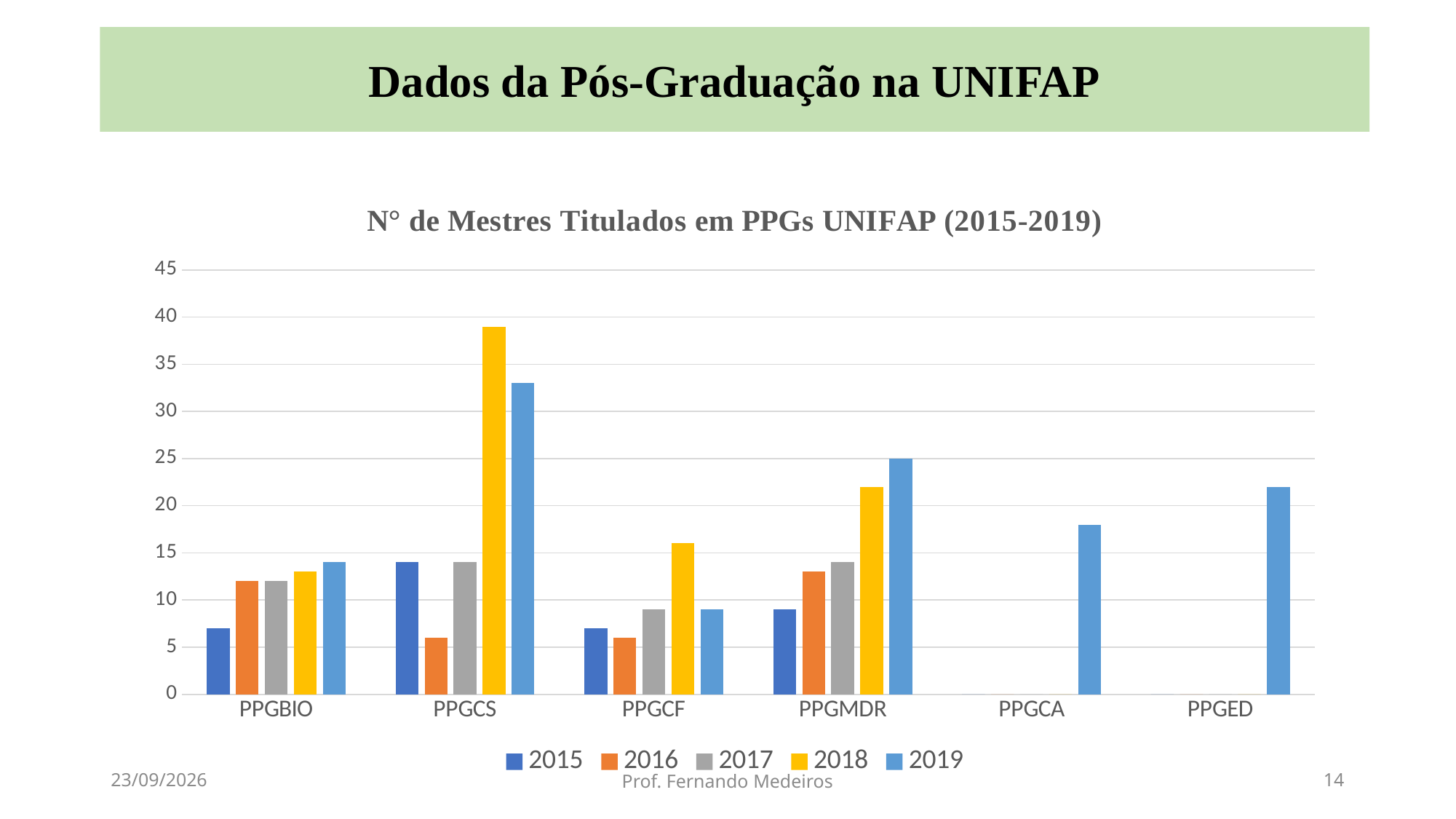
How many series does the legend list? 5 For PPGCS, which year has the highest number of titled masters? 2018 Is the 2019 value for PPGCA greater or less than 20? less Do the values for PPGMDR rise or fall from 2015 to 2019? rise How many programs (categories) are shown on the x axis? 6 Which is larger, the 2019 value for PPGCS or the 2019 value for PPGMDR? PPGCS Is the 2018 value for PPGCS greater or less than 35? greater Which program has the tallest bar in the chart? PPGCS What is the title of the chart? N° de Mestres Titulados em PPGs UNIFAP (2015-2019) Which program has the lowest 2019 value among those with bars for all five years? PPGCF What kind of chart is shown on the slide? bar chart Is the 2019 value for PPGED greater or less than 20? greater